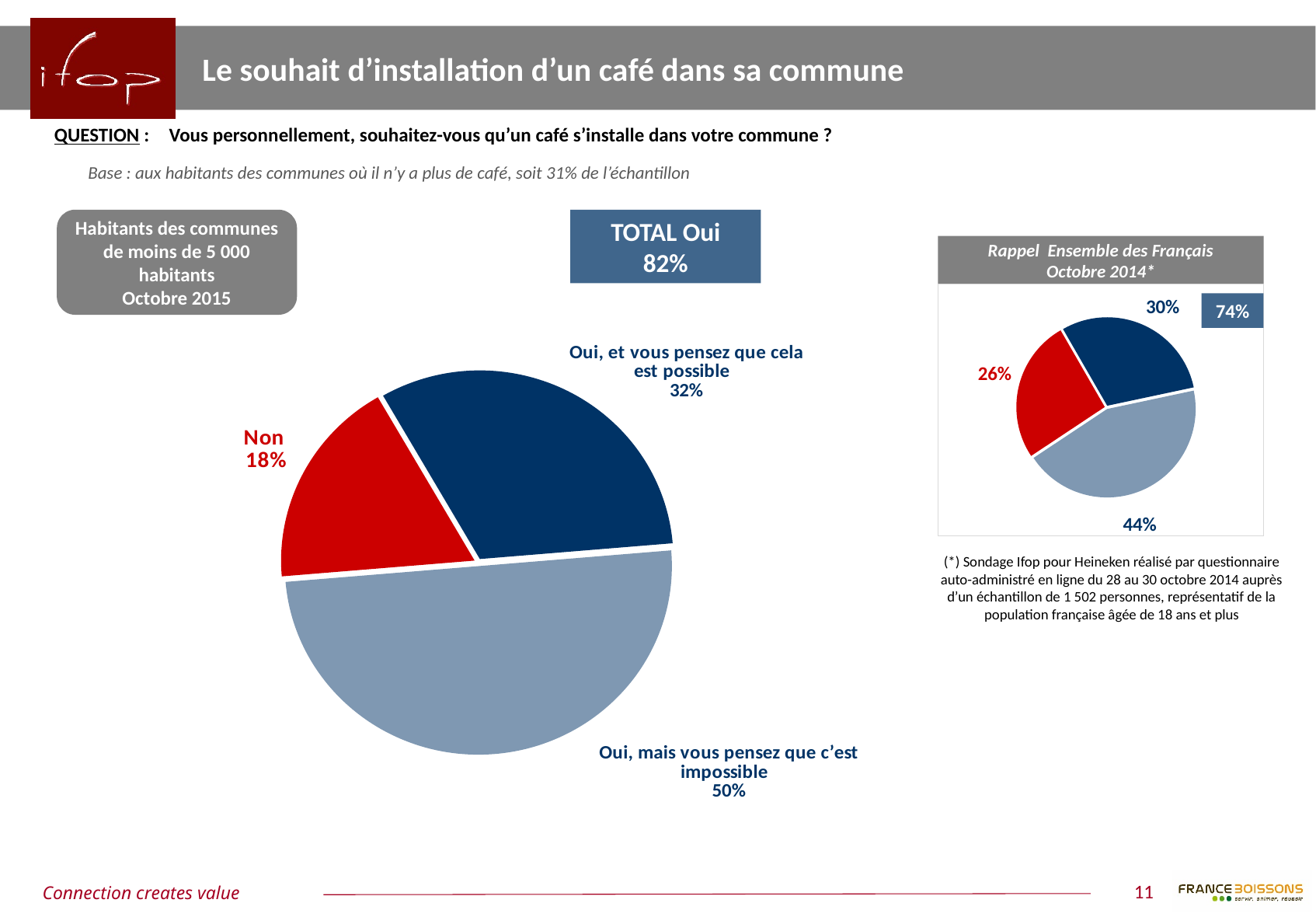
In the large pie chart (Octobre 2015), what share of respondents answered "Non"? 18% What is the TOTAL Oui value shown above the large pie chart? 82% In the large pie chart (Octobre 2015), which response has the smallest share? Non What type of chart is used on this slide? Pie chart In the large pie chart (Octobre 2015), what is the difference between the share for "Oui, mais vous pensez que c'est impossible" and the share for "Non"? 32 points In the small pie chart on the right (Rappel Ensemble des Français Octobre 2014), what is the value of the red slice? 26% What is the total shown in the box next to the small pie chart on the right (Rappel Ensemble des Français Octobre 2014)? 74% In the large pie chart (Octobre 2015), what share answered "Oui, mais vous pensez que c'est impossible"? 50% In the large pie chart (Octobre 2015), which response has the largest share? Oui, mais vous pensez que c'est impossible How many slices does the large pie chart (Octobre 2015) have? 3 In the small pie chart on the right (Rappel Ensemble des Français Octobre 2014), what is the largest slice value? 44% In the large pie chart (Octobre 2015), what share answered "Oui, et vous pensez que cela est possible"? 32%